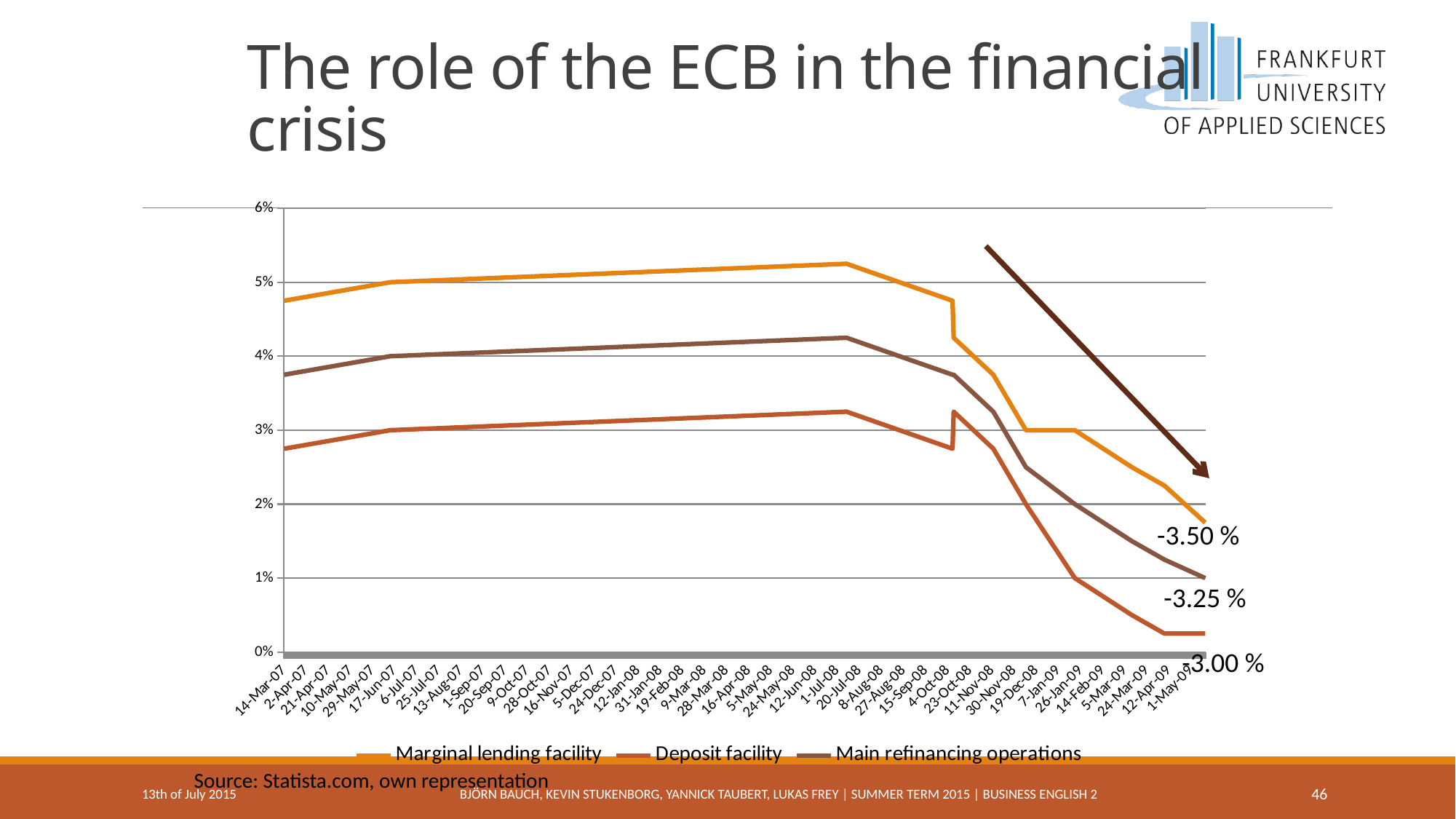
At 1-May-09, which is larger: Marginal lending facility or Deposit facility? Marginal lending facility Is the value for Marginal lending facility at 14-Mar-07 greater or less than 4%? greater Is the value for Main refinancing operations at 14-Mar-07 greater or less than 3%? greater Is the value for Marginal lending facility at 1-May-09 greater or less than 2%? less What is the first date label on the x axis? 14-Mar-07 What change is annotated next to the Marginal lending facility line at the right of the chart? -3.50 % Do the values of the Main refinancing operations series rise or fall between 23-Oct-08 and 1-May-09? fall Which series has the highest values across the whole period? Marginal lending facility How many series does the legend list? 3 Which series has the lowest values across the whole period? Deposit facility What kind of chart is shown on the slide? line chart